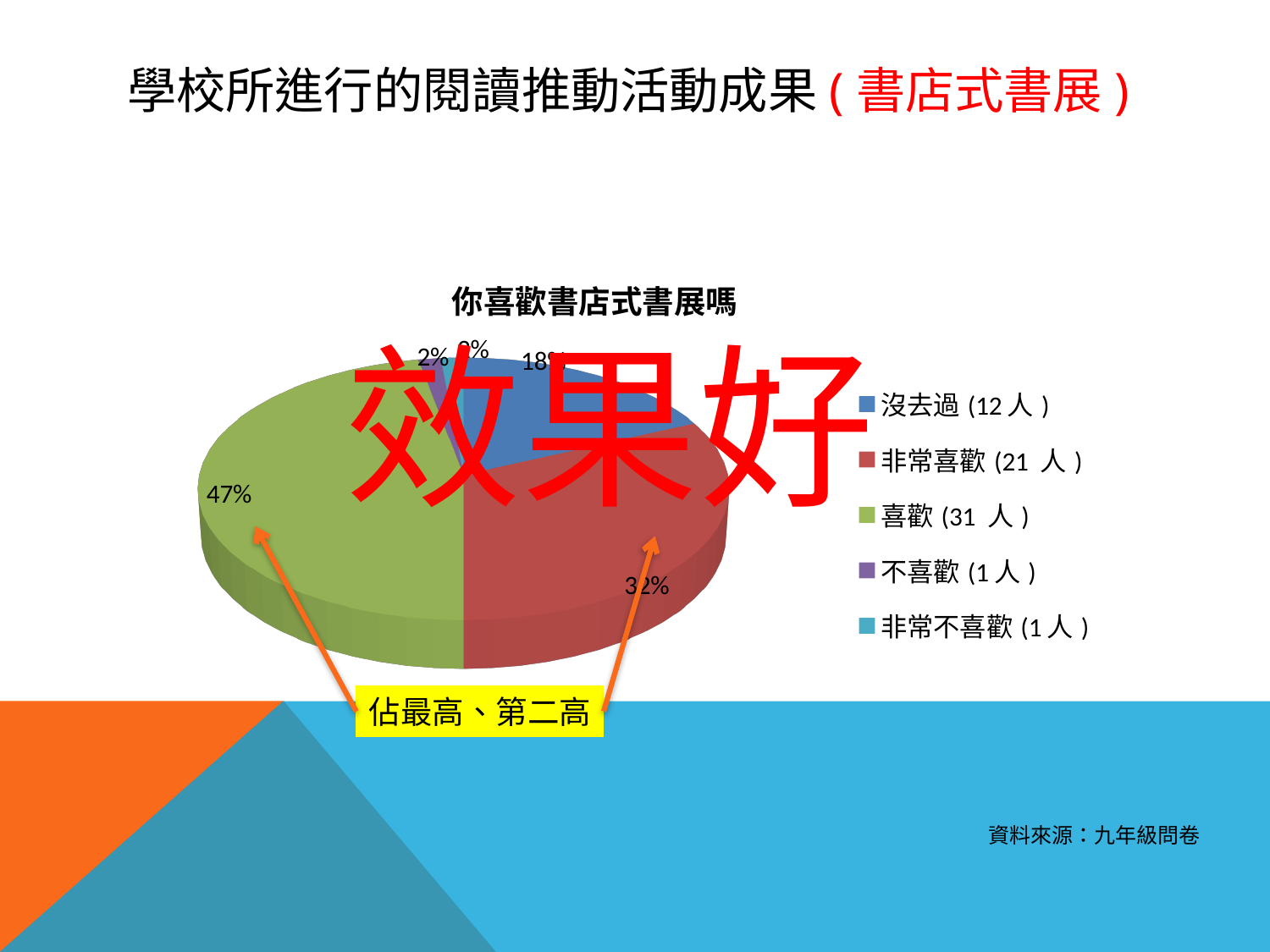
What percentage of the pie does 喜歡 take? 47% What is the title of the pie chart? 你喜歡書店式書展嗎 How many more people answered 喜歡 than 非常喜歡? 10 人 According to the legend, how many people answered 沒去過? 12 人 According to the legend, how many people answered 非常喜歡? 21 人 According to the legend, how many people answered 喜歡? 31 人 Which category has more respondents, 喜歡 or 非常喜歡? 喜歡 What percentage of the pie does 不喜歡 take? 2% What kind of chart is shown on the slide? Pie chart Which category has the largest share of the pie? 喜歡 What is the data source stated on the slide? 九年級問卷 How many categories does the pie chart have? 5